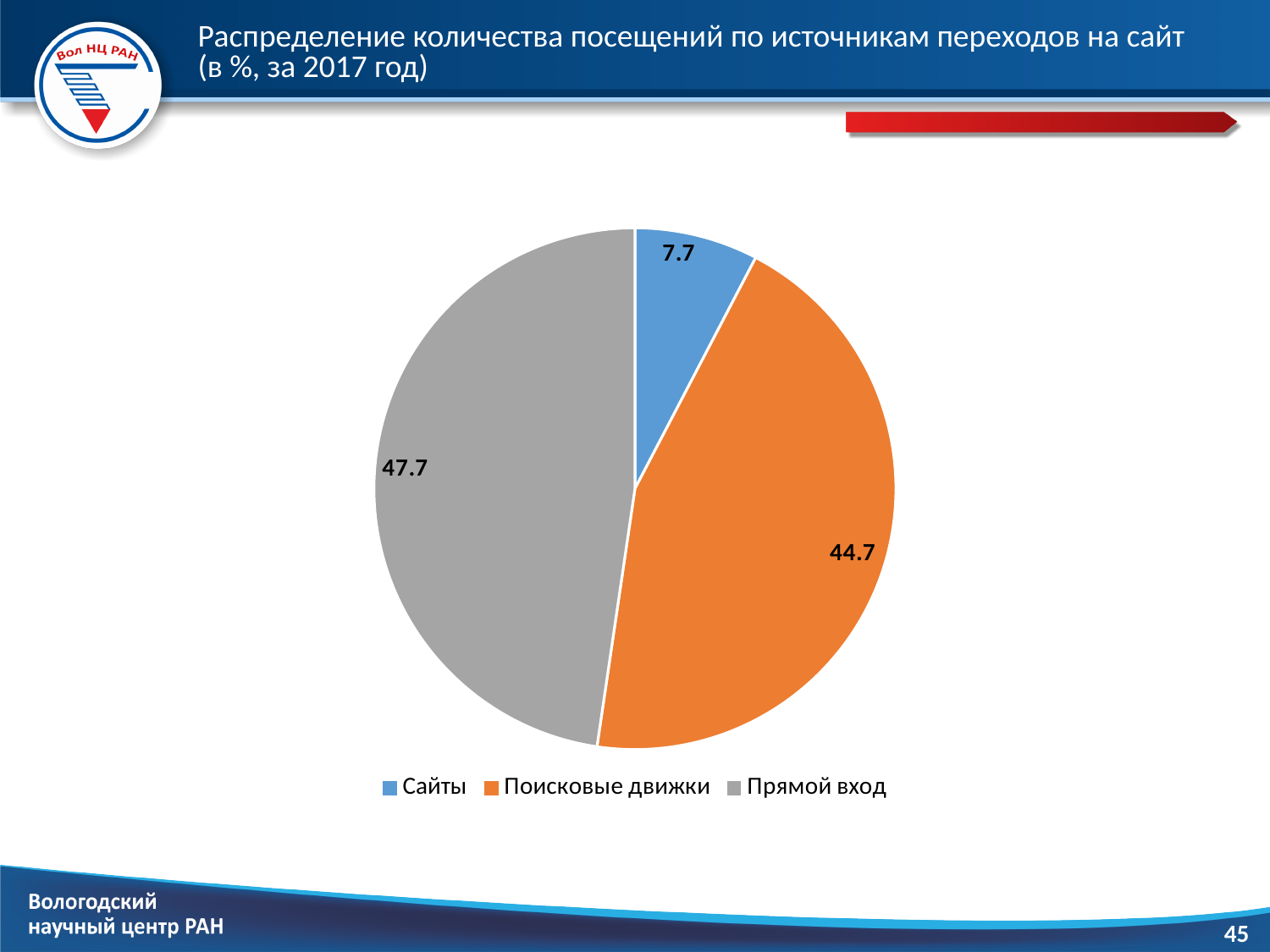
Which category has the largest share of the pie? Прямой вход What type of chart is shown on the slide? pie chart What is the value for Поисковые движки? 44.7 What colour is the slice for Поисковые движки? orange What is the difference between the values for Прямой вход and Поисковые движки? 3.0 Which category has the smallest share of the pie? Сайты What is the value for Прямой вход? 47.7 How many entries does the legend list? 3 Which is larger, the value for Сайты or the value for Поисковые движки? Поисковые движки How many categories does the pie chart have? 3 What is the value for Сайты? 7.7 What is the difference between the values for Поисковые движки and Сайты? 37.0